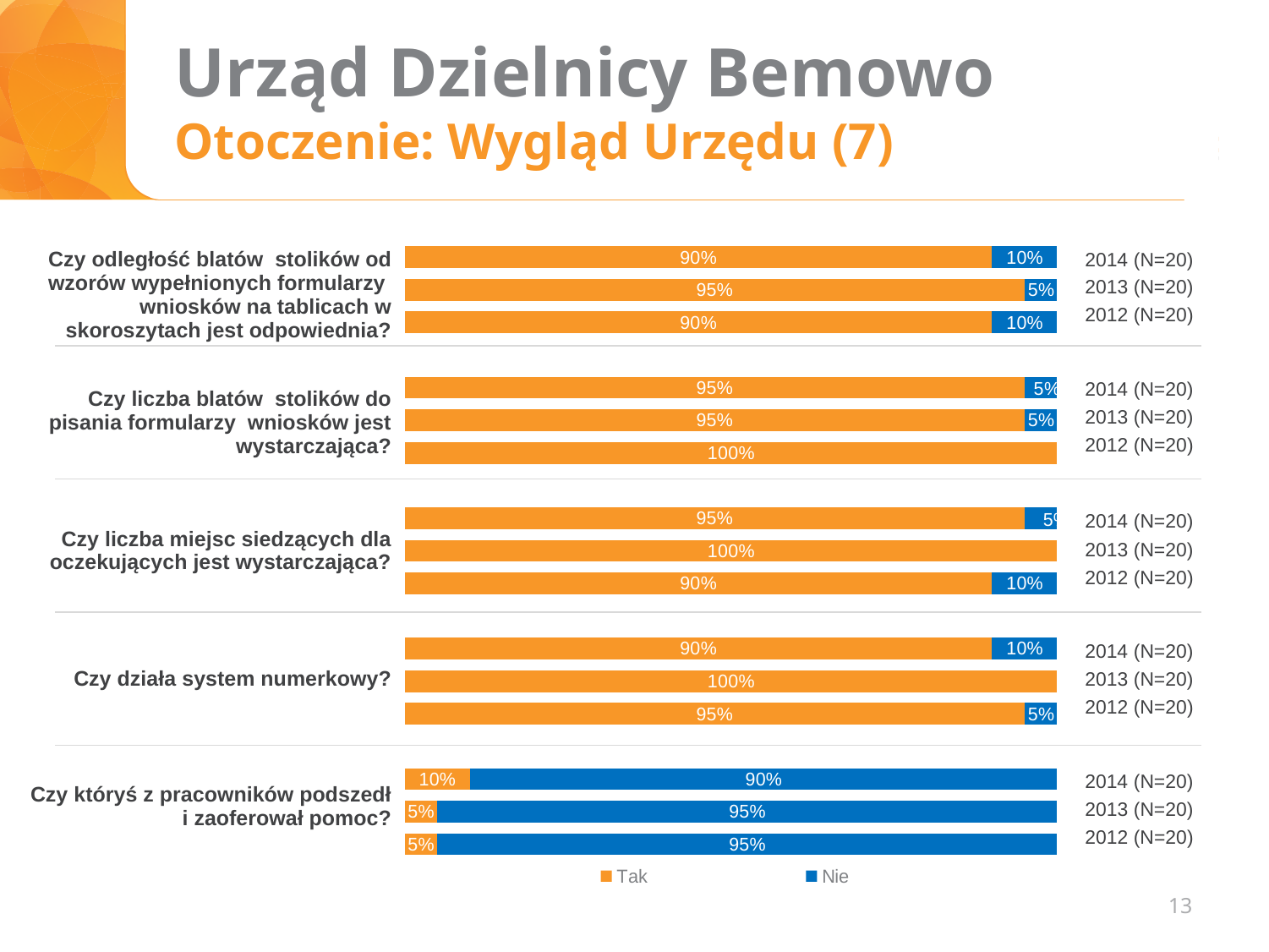
How many years are shown for each question on the slide? 3 Which colour represents "Nie" in the legend? Blue In the chart for "Czy działa system numerkowy?", what is the difference between the "Tak" share in 2013 and in 2014? 10% In the chart for "Czy któryś z pracowników podszedł i zaoferował pomoc?", is the "Tak" share larger in 2014 or in 2013? 2014 In the chart for "Czy działa system numerkowy?", what percentage answered "Tak" in 2014 (N=20)? 90% In the chart for "Czy któryś z pracowników podszedł i zaoferował pomoc?", what percentage answered "Nie" in 2013 (N=20)? 95% In the chart for "Czy liczba miejsc siedzących dla oczekujących jest wystarczająca?", what percentage answered "Tak" in 2012 (N=20)? 90% How many series does the legend list? 2 What kind of chart is used on the slide? Stacked bar chart In the chart for "Czy liczba blatów stolików do pisania formularzy wniosków jest wystarczająca?", which year has the highest "Tak" share? 2012 (N=20) In the chart for "Czy liczba miejsc siedzących dla oczekujących jest wystarczająca?", what is the total of the 2014 (N=20) bar? 100% In the chart for "Czy odległość blatów stolików od wzorów wypełnionych formularzy wniosków na tablicach w skoroszytach jest odpowiednia?", which year has the lowest "Nie" share? 2013 (N=20)